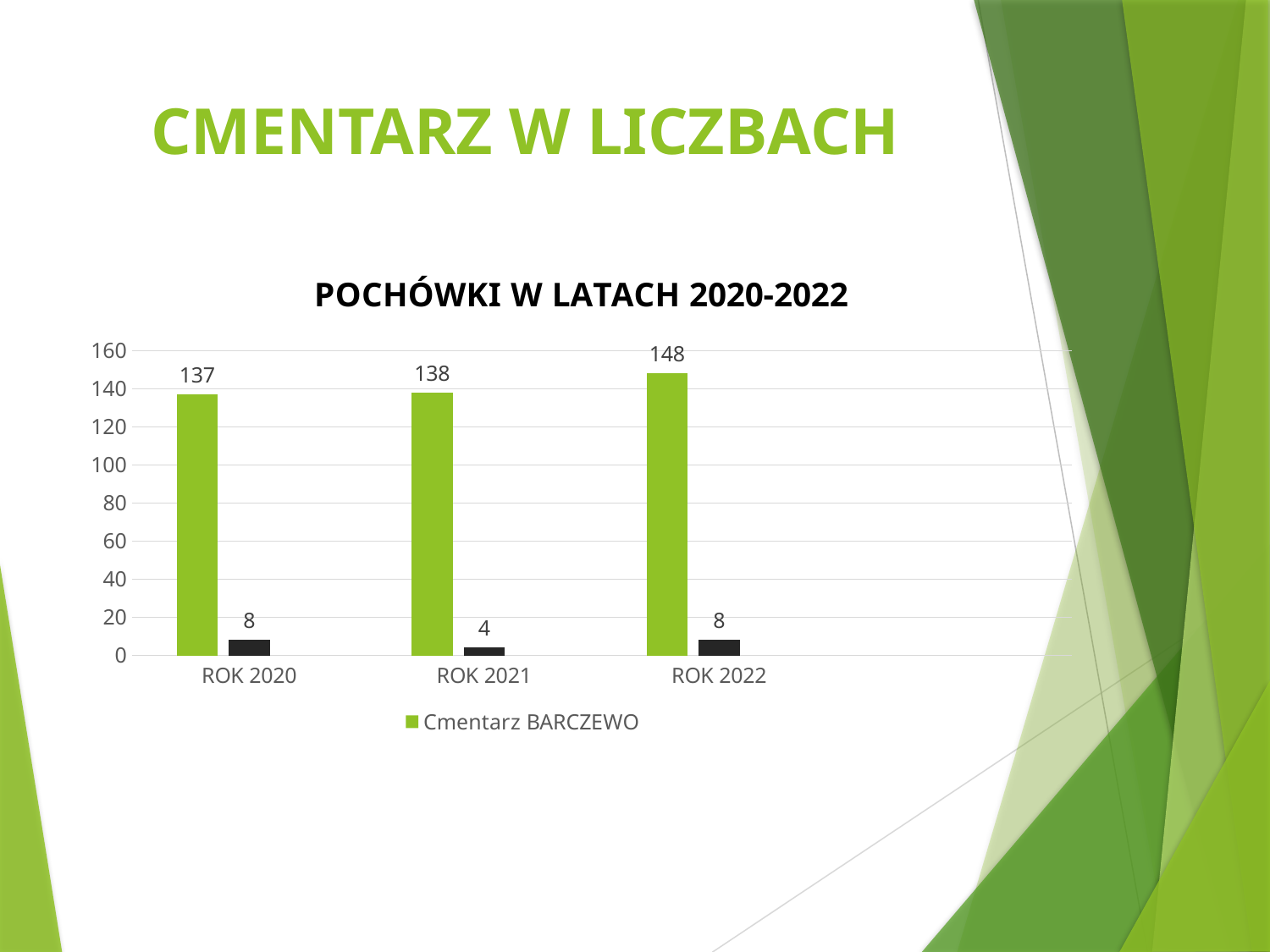
How many series does the legend list? 1 How many years are shown on the x axis of the chart? 3 Which year has the highest value for Cmentarz BARCZEWO? ROK 2022 What is the title of the chart? POCHÓWKI W LATACH 2020-2022 Which year has the lowest value for Cmentarz BARCZEWO? ROK 2020 Do the Cmentarz BARCZEWO values rise or fall from ROK 2020 to ROK 2022? rise What is the value for Cmentarz BARCZEWO in ROK 2022? 148 What kind of chart is shown on the slide? bar chart Is the Cmentarz BARCZEWO value for ROK 2022 greater or less than 140? greater What is the value for Cmentarz BARCZEWO in ROK 2021? 138 What is the difference between the Cmentarz BARCZEWO values for ROK 2022 and ROK 2020? 11 What is the value for Cmentarz BARCZEWO in ROK 2020? 137